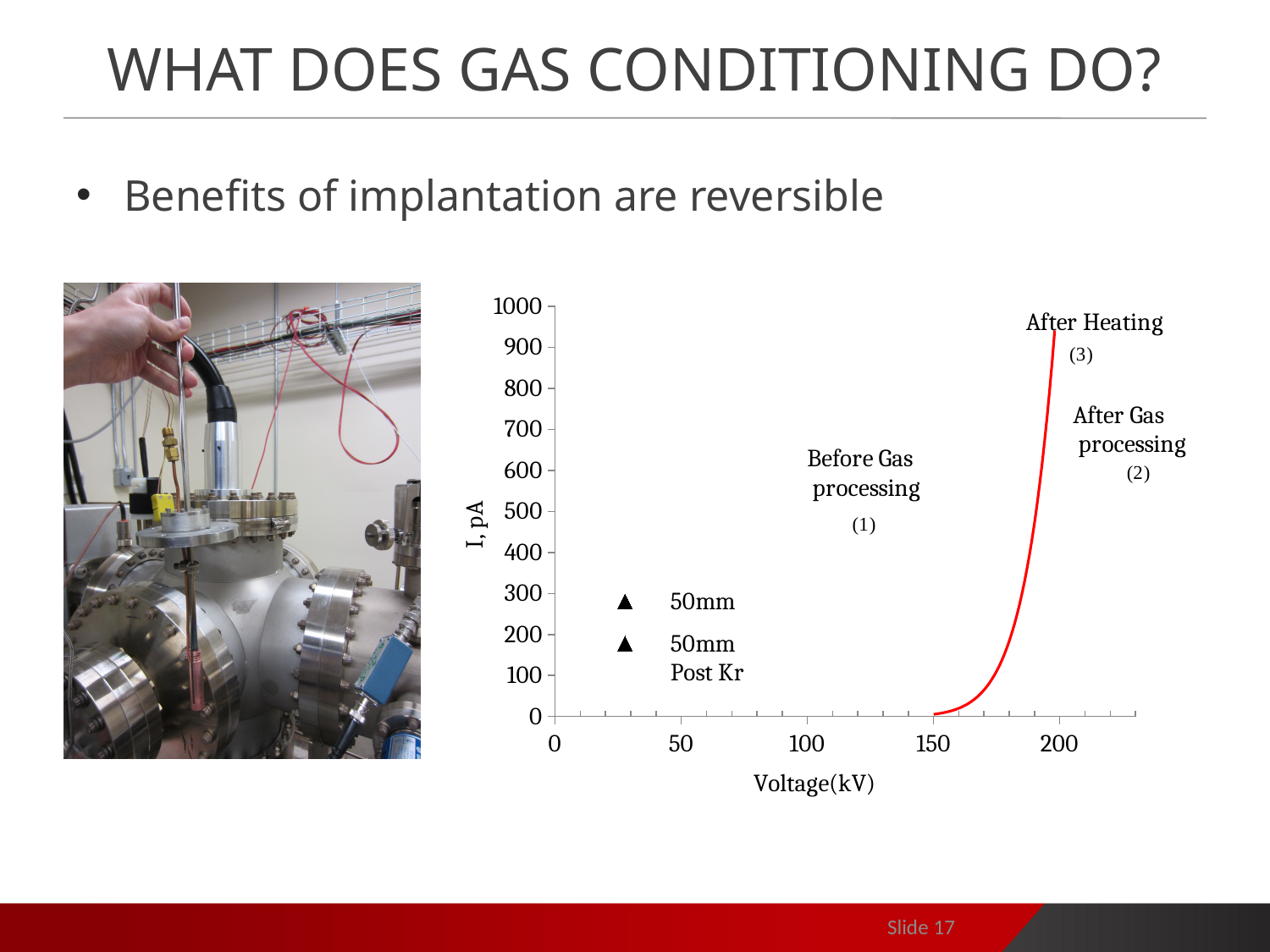
What kind of chart is shown on the slide? line chart What is the label of the x axis of the chart? Voltage(kV) Is the highest current reached by the red curve greater or less than 500 pA? greater What is the highest tick value shown on the y axis? 1000 How many series does the chart's legend list? 2 Is the current at 150 kV greater or less than 100 pA? less How many numbered stages are annotated on the chart? 3 Does the current rise or fall as voltage increases along the x axis? rise What is the label of the y axis of the chart? I, pA Is the current at 175 kV greater or less than 500 pA? less